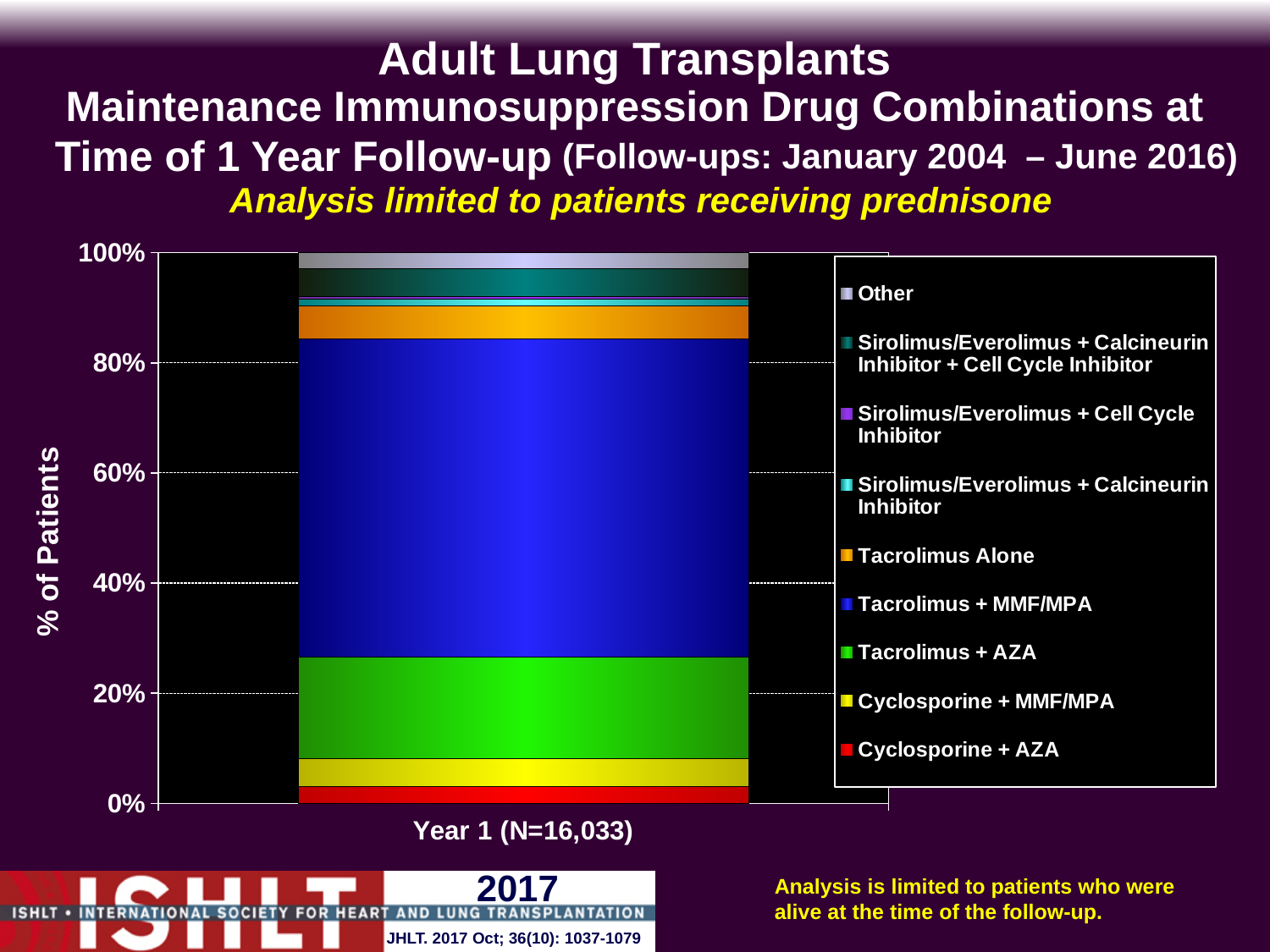
Which is larger, the segment for Tacrolimus Alone or the segment for Tacrolimus + MMF/MPA? Tacrolimus + MMF/MPA Which is larger, the segment for Tacrolimus + AZA or the segment for Cyclosporine + AZA? Tacrolimus + AZA What does the stacked Year 1 bar total to on the y axis? 100% How many series does the legend list? 9 Is the share for Tacrolimus + MMF/MPA greater or less than 40%? greater Is the share for Cyclosporine + AZA greater or less than 20%? less What is the label of the y axis? % of Patients What is the label of the single category on the x axis? Year 1 (N=16,033) Which drug combination makes up the largest segment of the Year 1 bar? Tacrolimus + MMF/MPA What kind of chart is shown on the slide? Stacked bar chart How many bars (categories) are plotted on the x axis? 1 Is the share for Tacrolimus + AZA greater or less than 40%? less